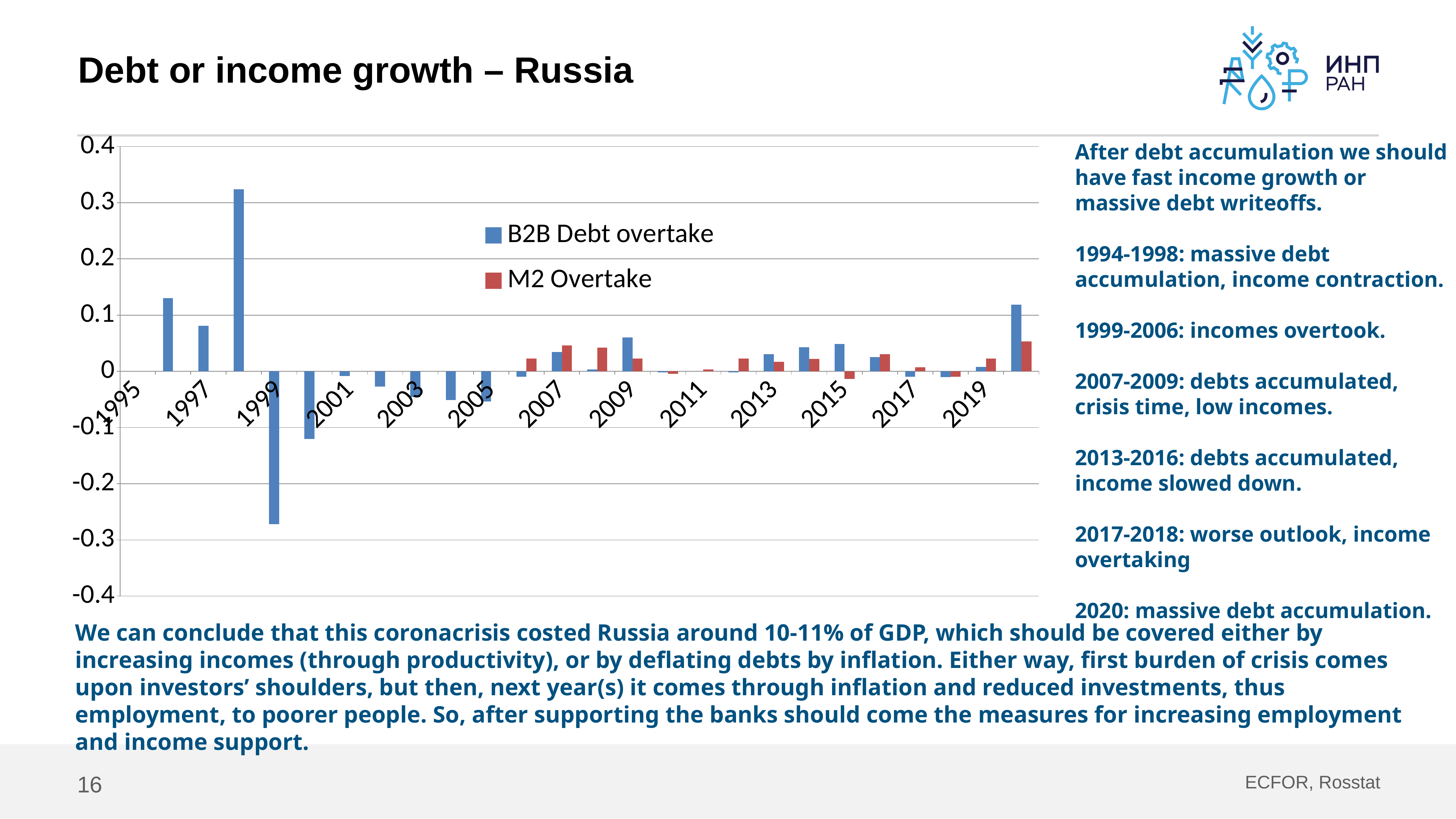
Is the B2B Debt overtake value for 2020 greater or less than 0.1? greater Is the B2B Debt overtake value for 1998 greater or less than 0.3? greater Is the B2B Debt overtake value for 1999 greater or less than -0.2? less In which year does the B2B Debt overtake series reach its highest value? 1998 What are the two series named in the chart legend? B2B Debt overtake and M2 Overtake What kind of chart is shown on the slide? bar chart Which year has the larger B2B Debt overtake value, 1996 or 1998? 1998 Which is larger for 2020: the B2B Debt overtake value or the M2 Overtake value? B2B Debt overtake Which colour represents the M2 Overtake series in the chart? red In which year does the B2B Debt overtake series reach its lowest value? 1999 How many series does the chart legend list? 2